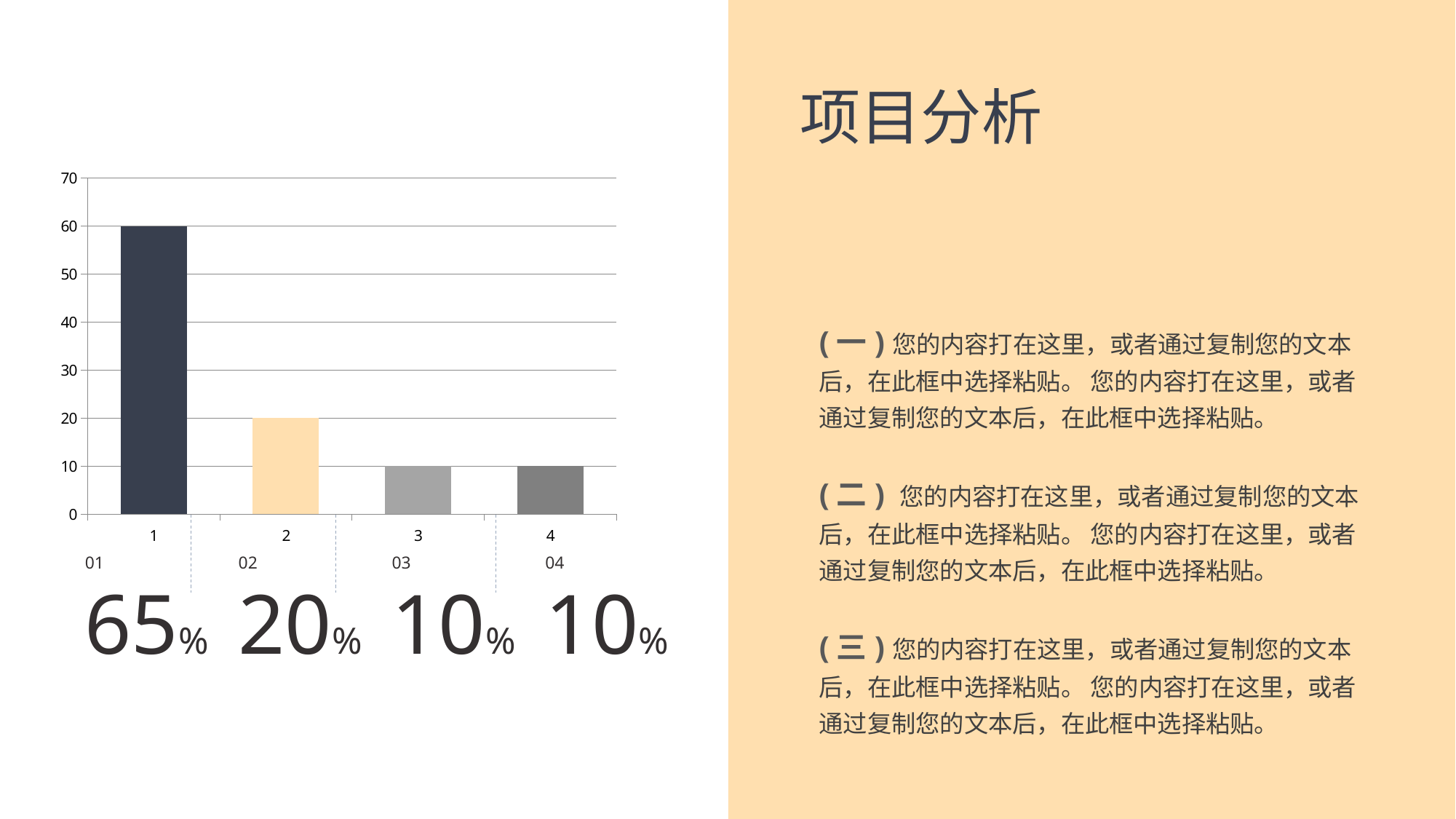
Is the value for category 1 greater or less than 50? greater What is the value of the bar for category 2? 20 Which is larger, the bar for category 2 or the bar for category 3? category 2 What is the difference between the values for category 1 and category 2? 40 What is the highest value shown on the vertical axis? 70 How many bars does the chart have? 4 What type of chart is shown on the slide? bar chart What is the value of the bar for category 1? 60 What colour is the bar for category 2? light orange Do the bar values generally rise or fall from category 1 to category 4? fall Which category has the highest bar? 1 What is the value of the bar for category 3? 10